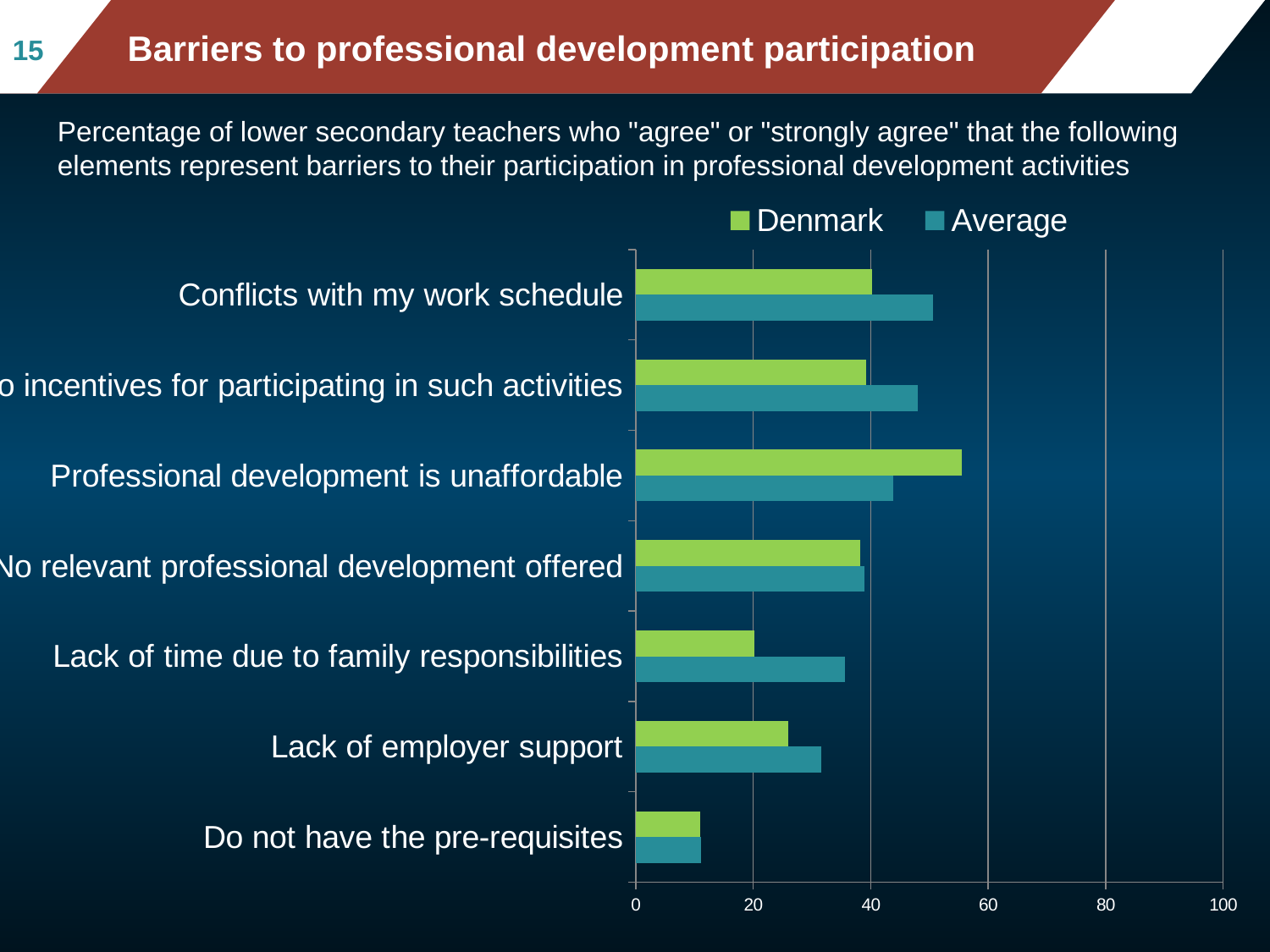
Which barrier has the highest value for Denmark? Professional development is unaffordable For 'Lack of time due to family responsibilities', which is larger: the Denmark value or the Average value? Average For 'Professional development is unaffordable', which is larger: the Denmark value or the Average value? Denmark What kind of chart is shown on the slide? bar chart Which barrier has the lowest value for Denmark? Do not have the pre-requisites Is the Denmark value for 'Do not have the pre-requisites' greater or less than 20? less Which series is shown in green in the legend? Denmark Is the Denmark value for 'Professional development is unaffordable' greater or less than 40? greater How many barrier categories are plotted on the chart? 7 Is the Average value for 'Conflicts with my work schedule' greater or less than 40? greater How many series does the legend list? 2 Which barrier has the lowest value for the Average series? Do not have the pre-requisites